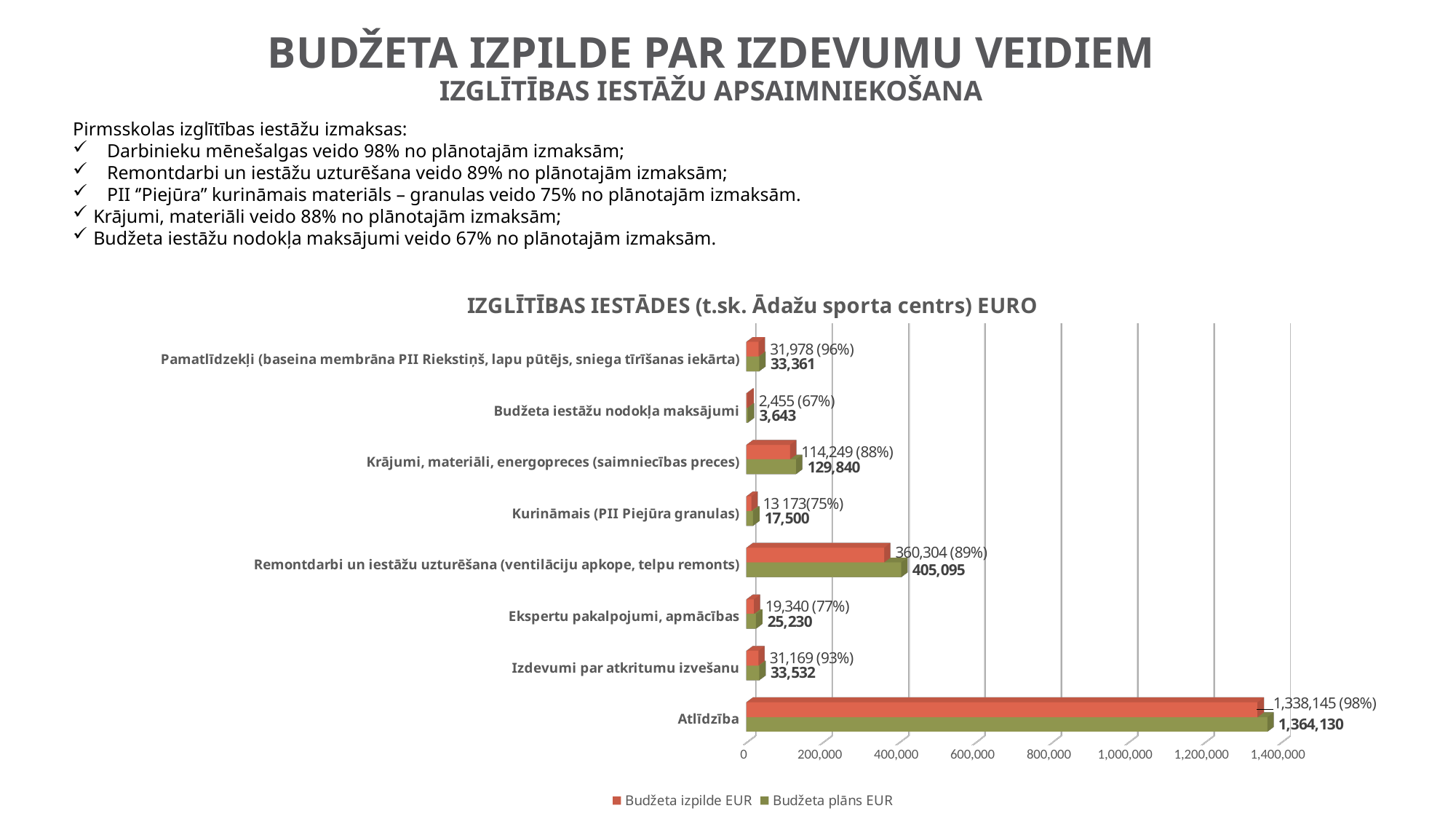
What type of chart is shown on the slide? bar chart What percentage of the plan is shown next to the Budžeta izpilde EUR value for Budžeta iestāžu nodokļa maksājumi? 67% What is the Budžeta izpilde EUR value for Remontdarbi un iestāžu uzturēšana (ventilāciju apkope, telpu remonts)? 360,304 What is the Budžeta plāns EUR value for Krājumi, materiāli, energopreces (saimniecības preces)? 129,840 Which is larger for Ekspertu pakalpojumi, apmācības: the Budžeta izpilde EUR value or the Budžeta plāns EUR value? Budžeta plāns EUR What is the Budžeta plāns EUR value for Atlīdzība? 1,364,130 How many categories are shown on the chart? 8 Which category has the highest Budžeta izpilde EUR value? Atlīdzība Which category has the lowest Budžeta plāns EUR value? Budžeta iestāžu nodokļa maksājumi How many series does the chart legend list? 2 What is the difference between the Budžeta plāns EUR and Budžeta izpilde EUR values for Atlīdzība? 25,985 What is the title of the chart? IZGLĪTĪBAS IESTĀDES (t.sk. Ādažu sporta centrs) EURO